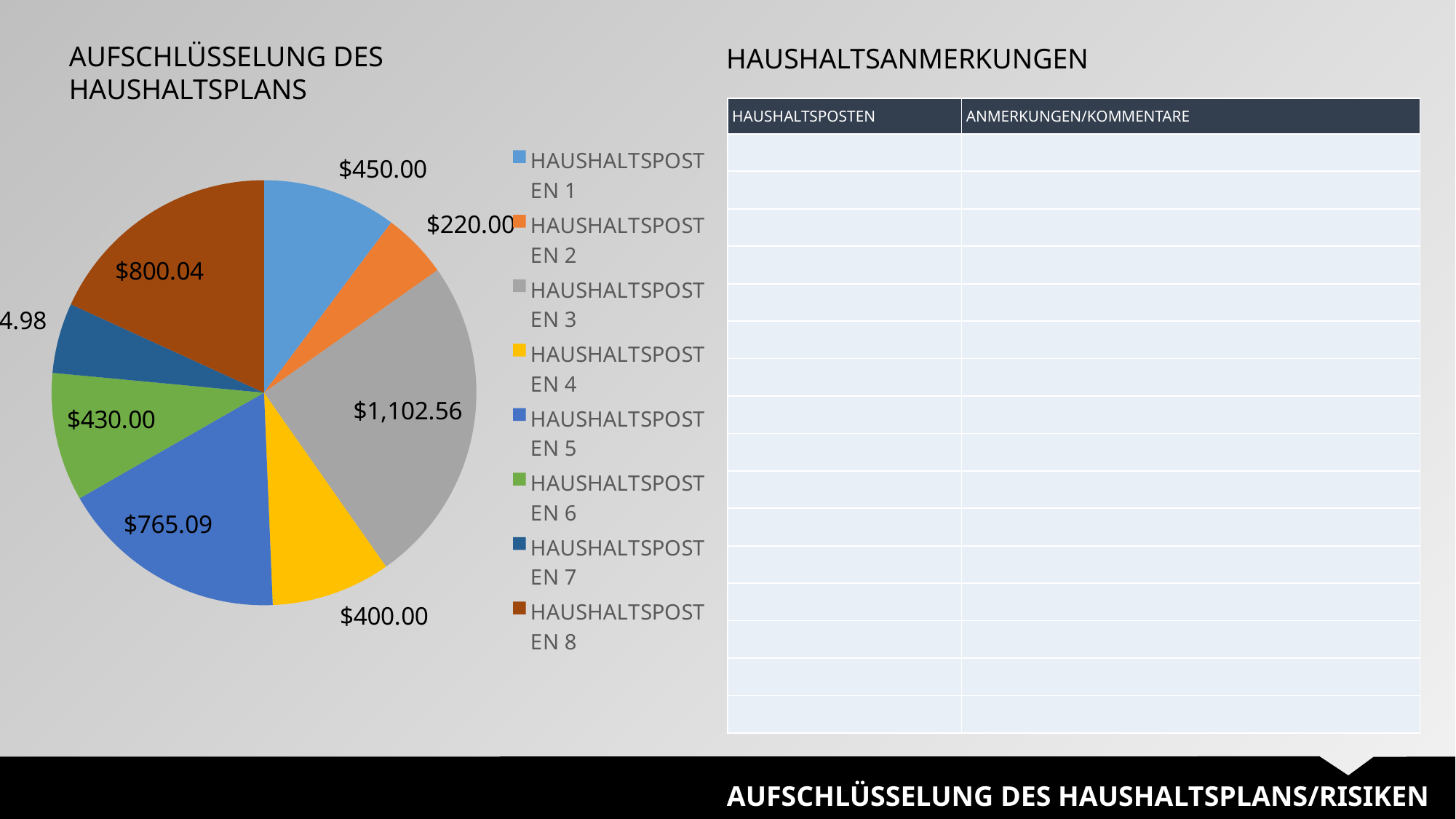
What colour is the slice for HAUSHALTSPOSTEN 6 in the pie chart? Green What is the value shown for HAUSHALTSPOSTEN 5 in the pie chart? $765.09 What is the value shown for HAUSHALTSPOSTEN 3 in the pie chart? $1,102.56 What is the difference between the values for HAUSHALTSPOSTEN 3 and HAUSHALTSPOSTEN 5 in the pie chart? $337.47 How many entries does the legend of the pie chart list? 8 What is the value shown for HAUSHALTSPOSTEN 2 in the pie chart? $220.00 What is the value shown for HAUSHALTSPOSTEN 1 in the pie chart? $450.00 What kind of chart is shown under the title "AUFSCHLÜSSELUNG DES HAUSHALTSPLANS"? Pie chart Which budget item has the largest slice in the pie chart? HAUSHALTSPOSTEN 3 What is the value shown for HAUSHALTSPOSTEN 8 in the pie chart? $800.04 Which is larger in the pie chart, HAUSHALTSPOSTEN 5 or HAUSHALTSPOSTEN 8? HAUSHALTSPOSTEN 8 How many slices does the pie chart have? 8